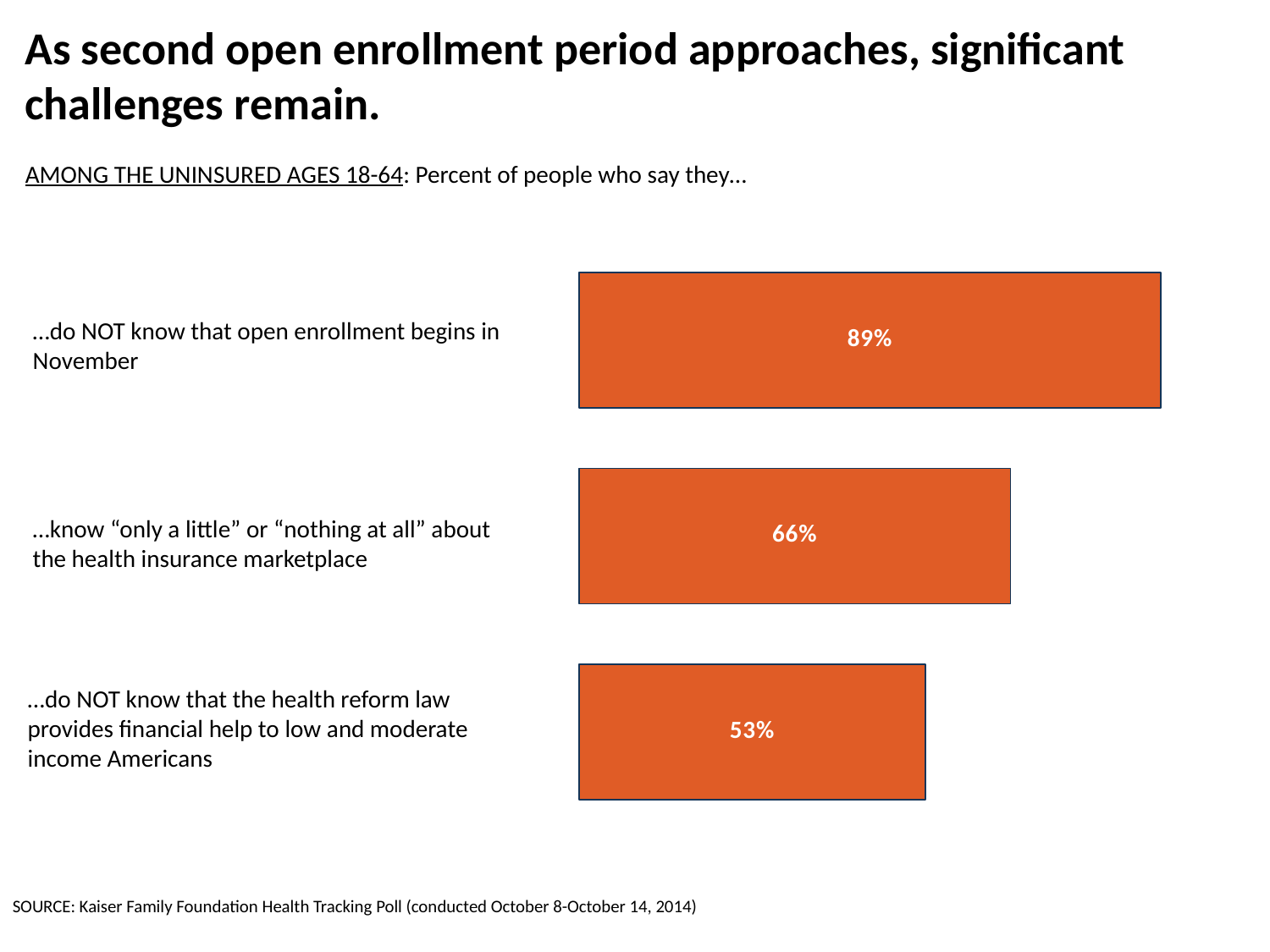
Which statement has the lowest percentage on the chart? ...do NOT know that the health reform law provides financial help to low and moderate income Americans Which is larger: the percentage who do NOT know that open enrollment begins in November or the percentage who know "only a little" or "nothing at all" about the marketplace? ...do NOT know that open enrollment begins in November What percent of the uninsured ages 18-64 say they know "only a little" or "nothing at all" about the health insurance marketplace? 66% What kind of chart is shown on the slide? Bar chart What colour are the bars on the chart? Orange Which statement has the highest percentage on the chart? ...do NOT know that open enrollment begins in November What percent of the uninsured ages 18-64 say they do NOT know that the health reform law provides financial help to low and moderate income Americans? 53% Which population group does the chart describe? The uninsured ages 18-64 What is the difference between the percentage who do NOT know that open enrollment begins in November and the percentage who do NOT know the law provides financial help? 36 percentage points How many bars are shown on the chart? 3 What is the difference between the percentage who know "only a little" or "nothing at all" about the marketplace and the percentage who do NOT know the law provides financial help? 13 percentage points What percent of the uninsured ages 18-64 say they do NOT know that open enrollment begins in November? 89%